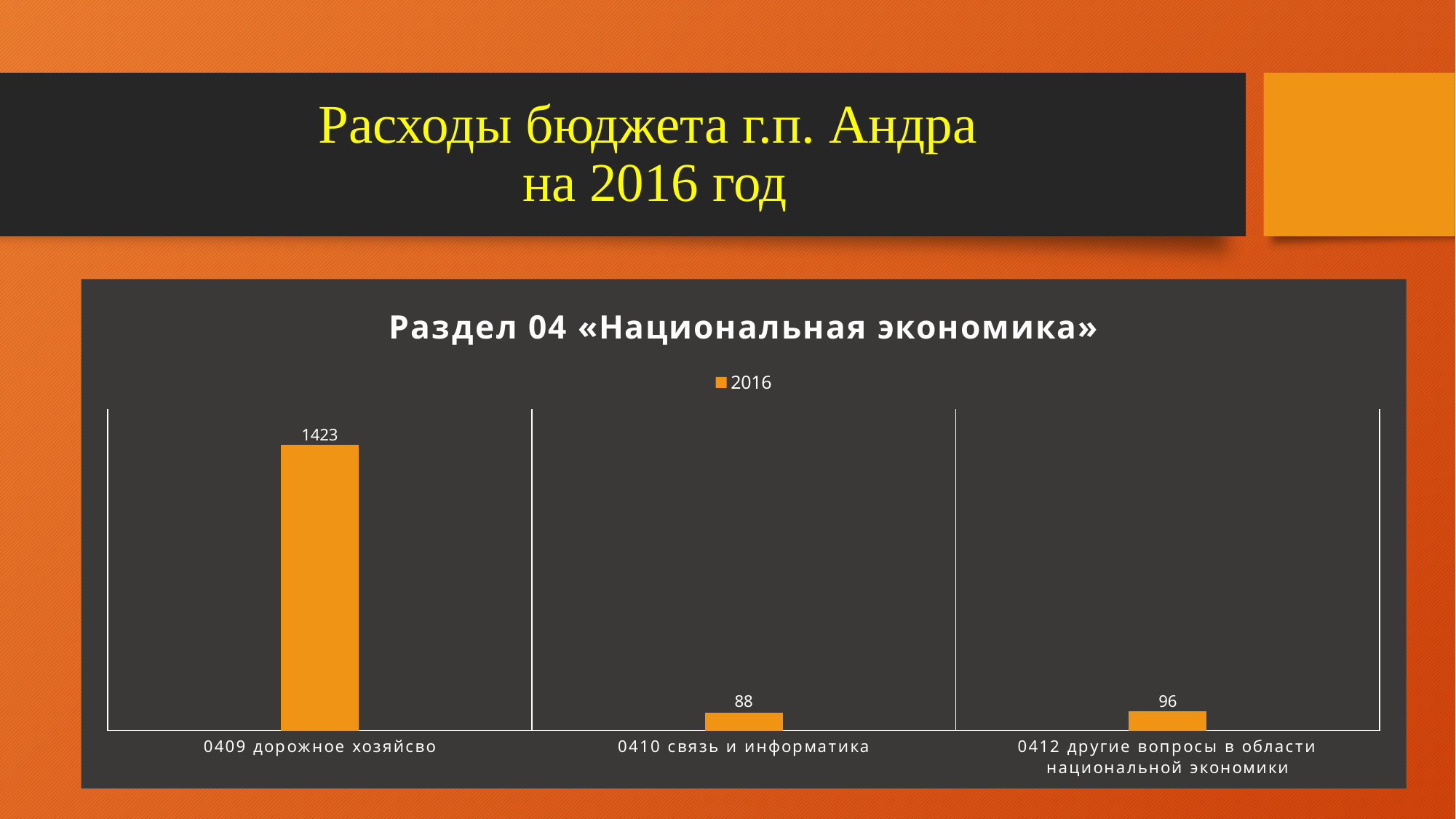
What is the value for 0410 связь и информатика? 88 What is the value for 0409 дорожное хозяйсво? 1423 What is the title of the chart? Раздел 04 «Национальная экономика» What is the difference between the values for 0409 дорожное хозяйсво and 0412 другие вопросы в области национальной экономики? 1327 Which category has the highest value? 0409 дорожное хозяйсво How many series does the legend list? 1 Which is larger: the value for 0409 дорожное хозяйсво or the value for 0410 связь и информатика? 0409 дорожное хозяйсво How many categories are shown on the x axis? 3 What is the difference between the values for 0412 другие вопросы в области национальной экономики and 0410 связь и информатика? 8 Which category has the lowest value? 0410 связь и информатика What is the value for 0412 другие вопросы в области национальной экономики? 96 What kind of chart is shown on the slide? bar chart